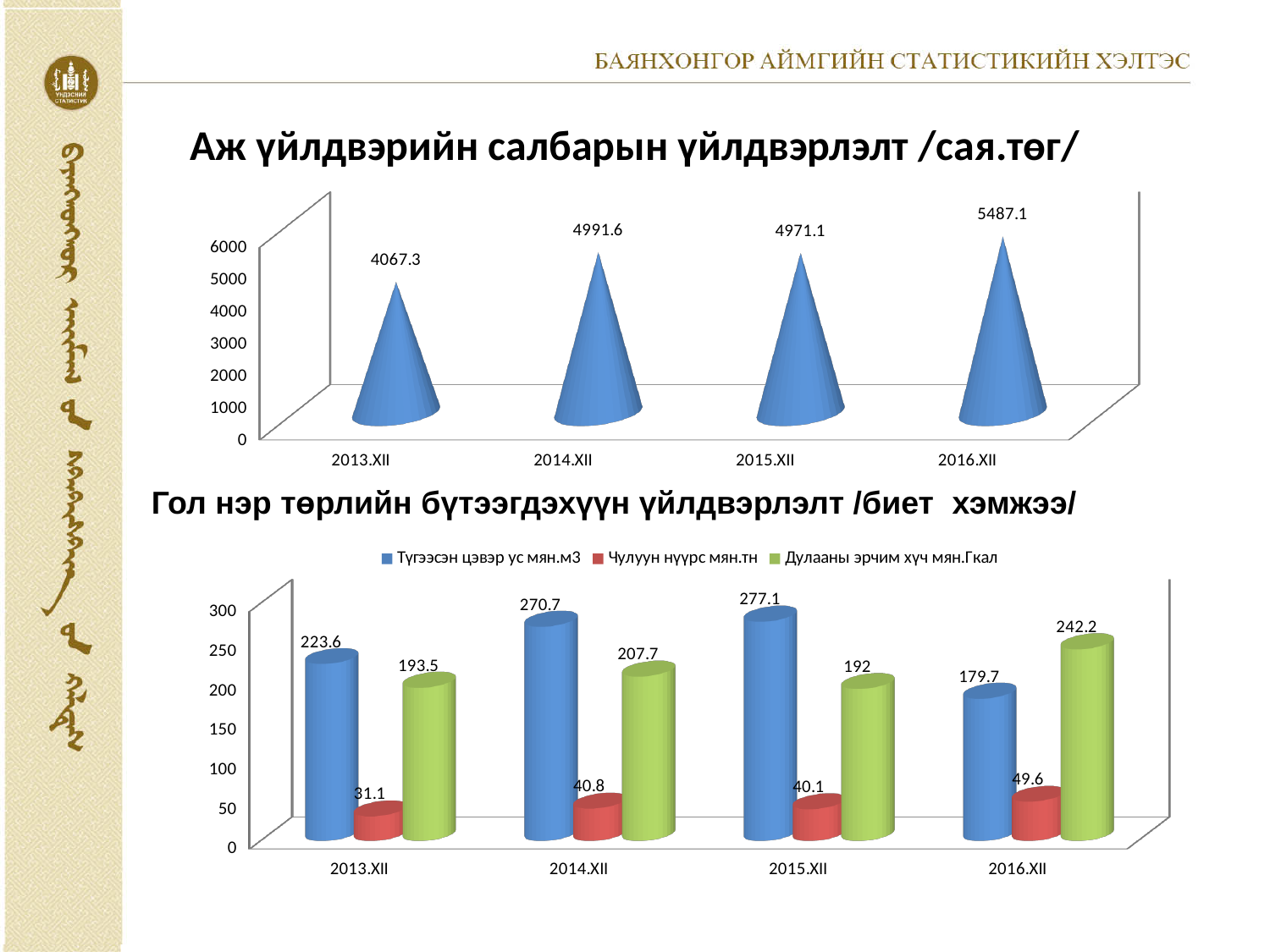
What kind of chart is the bottom chart (Гол нэр төрлийн бүтээгдэхүүн үйлдвэрлэлт /биет хэмжээ/)? Bar chart In the bottom chart (Гол нэр төрлийн бүтээгдэхүүн үйлдвэрлэлт /биет хэмжээ/), how many series does the legend list? 3 In the bottom chart (Гол нэр төрлийн бүтээгдэхүүн үйлдвэрлэлт /биет хэмжээ/), what is the difference between Түгээсэн цэвэр ус мян.м3 for 2015.XII and 2016.XII? 97.4 In the top chart (Аж үйлдвэрийн салбарын үйлдвэрлэлт /сая.төг/), what is the difference between the values for 2016.XII and 2013.XII? 1419.8 In the top chart (Аж үйлдвэрийн салбарын үйлдвэрлэлт /сая.төг/), what is the value for 2013.XII? 4067.3 In the top chart (Аж үйлдвэрийн салбарын үйлдвэрлэлт /сая.төг/), which period has the highest value? 2016.XII In the top chart (Аж үйлдвэрийн салбарын үйлдвэрлэлт /сая.төг/), how many periods are shown on the x axis? 4 In the bottom chart (Гол нэр төрлийн бүтээгдэхүүн үйлдвэрлэлт /биет хэмжээ/), which is larger for 2016.XII: Түгээсэн цэвэр ус мян.м3 or Дулааны эрчим хүч мян.Гкал? Дулааны эрчим хүч мян.Гкал In the bottom chart (Гол нэр төрлийн бүтээгдэхүүн үйлдвэрлэлт /биет хэмжээ/), what is the value of Дулааны эрчим хүч мян.Гкал for 2014.XII? 207.7 In the bottom chart (Гол нэр төрлийн бүтээгдэхүүн үйлдвэрлэлт /биет хэмжээ/), what is the value of Түгээсэн цэвэр ус мян.м3 for 2015.XII? 277.1 In the bottom chart (Гол нэр төрлийн бүтээгдэхүүн үйлдвэрлэлт /биет хэмжээ/), what is the value of Чулуун нүүрс мян.тн for 2016.XII? 49.6 In the top chart (Аж үйлдвэрийн салбарын үйлдвэрлэлт /сая.төг/), which period has the lowest value? 2013.XII